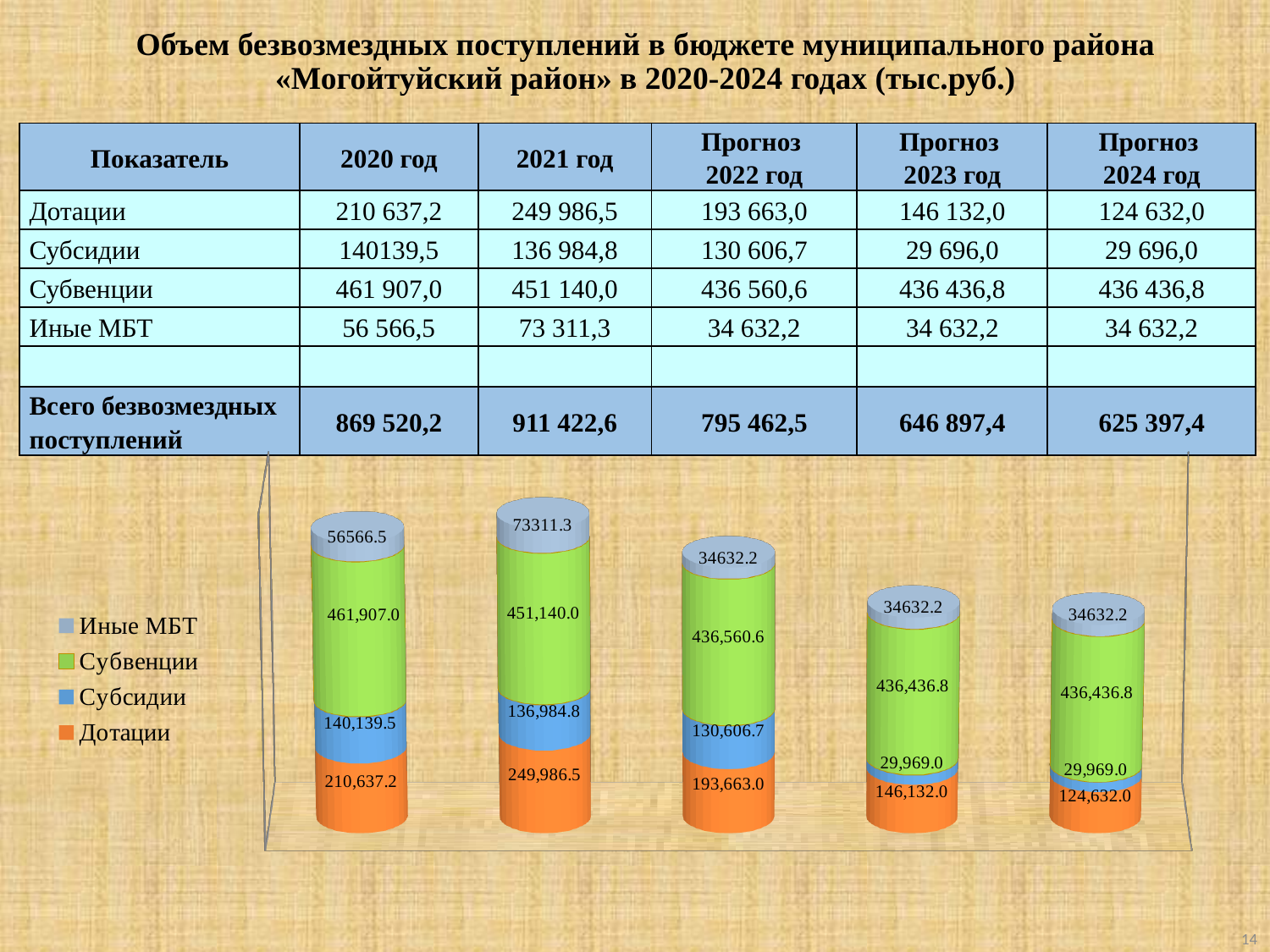
In the chart, is the Субсидии segment larger in the first bar or in the second bar from the left? The first bar How many stacked bars are plotted in the chart? 5 In the chart, what is the value of the Субвенции segment in the first bar from the left? 461,907.0 Which bar in the chart has the smallest Дотации segment? The fifth bar from the left (124,632.0) In the chart, what is the value of the Иные МБТ segment in the third bar from the left? 34632.2 In the chart, what is the value of the Дотации segment in the second bar from the left? 249,986.5 What kind of chart is shown on the slide? Stacked bar chart Which series is shown in orange in the chart legend? Дотации What is the total of the second stacked bar from the left in the chart? 911,422.6 Which bar in the chart has the largest Дотации segment? The second bar from the left (249,986.5) In the chart, what is the difference between the Субвенции segment of the first bar and that of the second bar from the left? 10,767.0 How many series does the chart legend list? 4